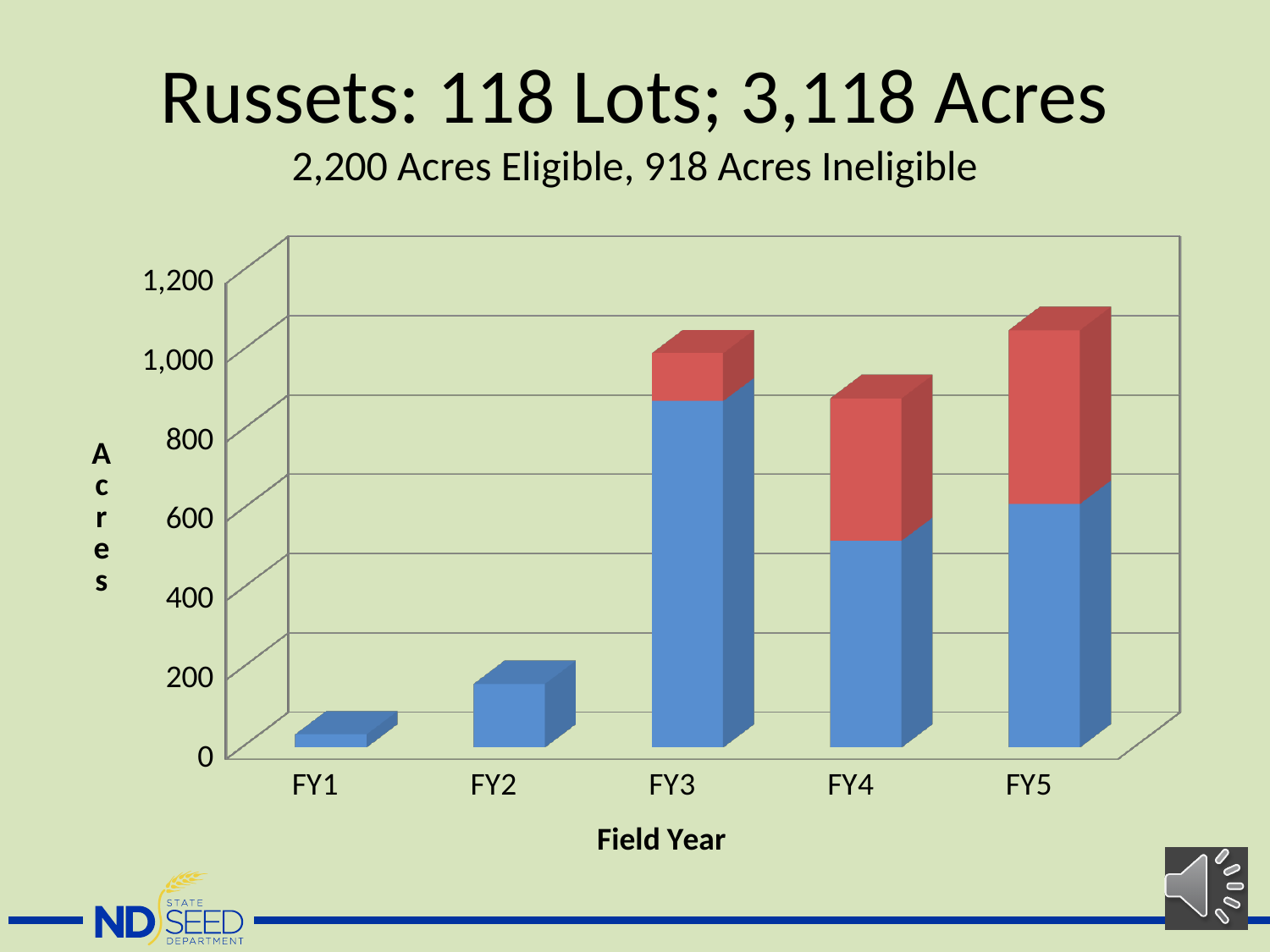
Is the total value for FY5 greater or less than 1,000 acres? greater Is the total value for FY4 greater or less than 800 acres? greater Which field year has the shortest bar in the chart? FY1 Is the value for FY1 greater or less than 200 acres? less What kind of chart is shown on the slide? bar chart What is the title of the x axis of the chart? Field Year Is the total bar for FY3 taller or shorter than the total bar for FY4? taller Which field year has the tallest bar in the chart? FY5 How many field years are shown on the x axis of the chart? 5 Do the bar heights rise or fall from FY1 to FY3? rise Which bar is taller, FY1 or FY2? FY2